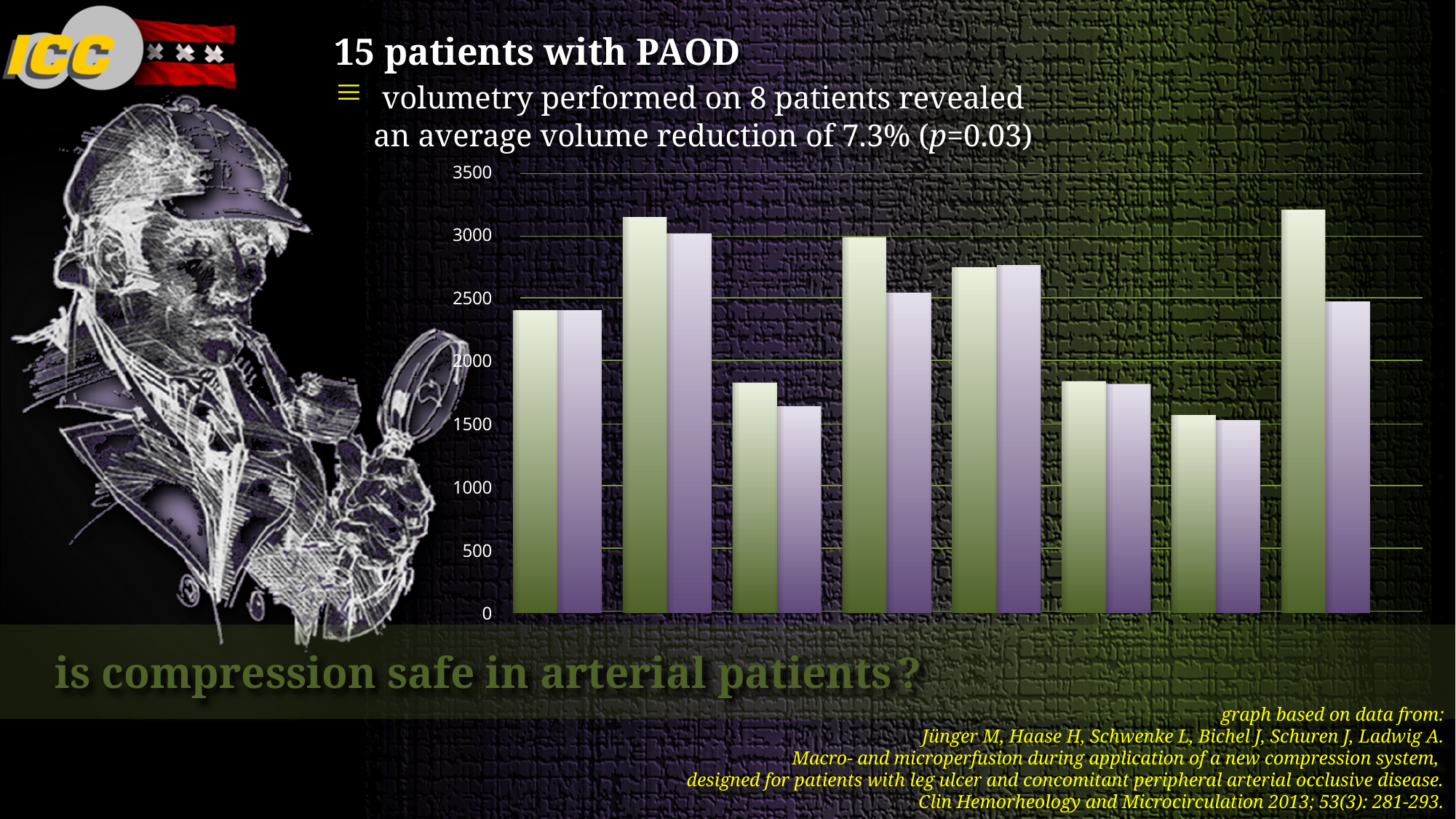
How many bars are there in each group? 2 Is the value of the green bar in the third group from the left greater or less than 2000? less How many groups of bars are plotted in the chart? 8 Is the value of the green bar in the first group from the left greater or less than 2000? greater In the rightmost group of bars, which bar is taller, the green one or the purple one? the green one Is the value of the green bar in the second group from the left greater or less than 3000? greater What two colours are used for the bars in the chart? green and purple What is the highest value shown on the vertical axis of the chart? 3500 Which group of bars, counted from the left, has the shortest green bar? the seventh What kind of chart is shown on the slide? bar chart